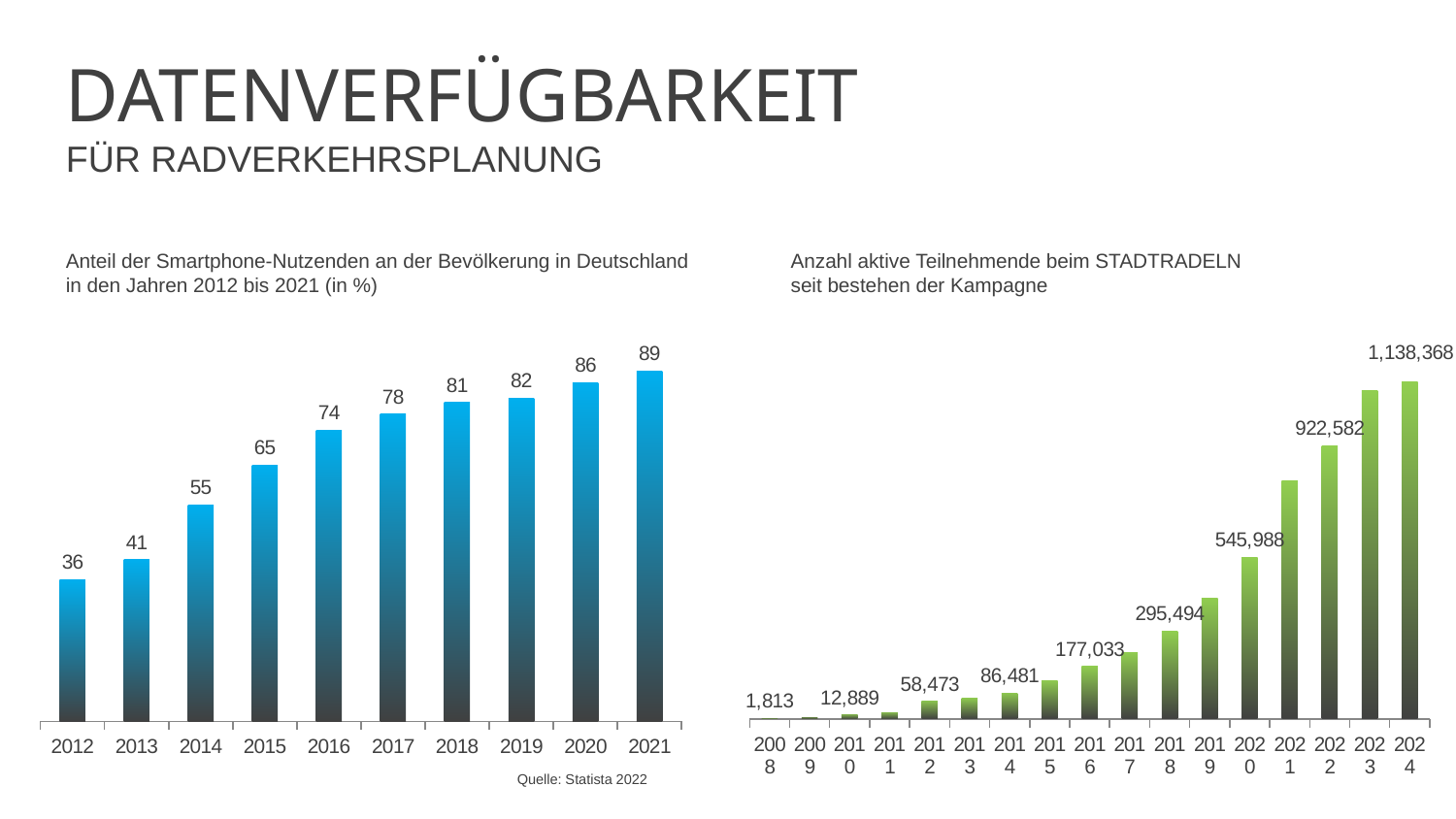
In the left chart on smartphone users in Germany, what is the difference between the values for 2021 and 2012? 53 In the right chart on STADTRADELN participants, which year has the highest value? 2024 How many years are shown in the left chart on smartphone users in Germany? 10 In the left chart on smartphone users in Germany, what is the value for 2012? 36 In the left chart on smartphone users in Germany, which year has the lowest value? 2012 In the right chart on STADTRADELN participants, what is the value for 2024? 1,138,368 In the left chart on smartphone users in Germany, what is the value for 2017? 78 What kind of chart is the left chart on smartphone users in Germany? bar chart In the right chart on STADTRADELN participants, what is the value for 2016? 177,033 How many years are shown in the right chart on STADTRADELN participants? 17 In the left chart on smartphone users in Germany, do the values rise or fall from 2012 to 2021? rise In the left chart on smartphone users in Germany, which year has the highest value? 2021